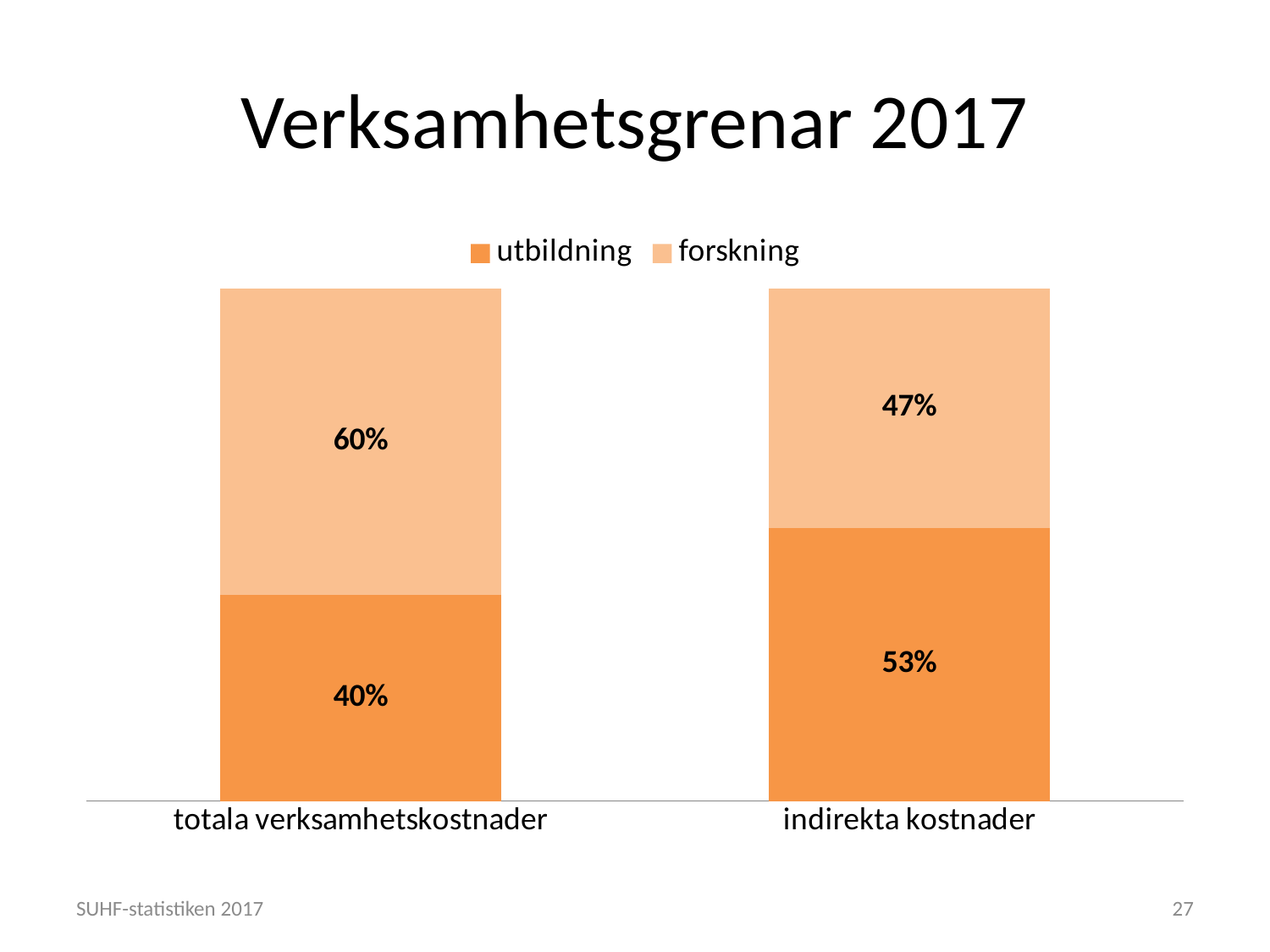
How many series does the legend list? 2 What is the value for forskning in the totala verksamhetskostnader bar? 60% What is the difference between the forskning and utbildning values for totala verksamhetskostnader? 20% Which category has the higher value for forskning? totala verksamhetskostnader What is the value for utbildning in the totala verksamhetskostnader bar? 40% What is the difference between the utbildning values for indirekta kostnader and totala verksamhetskostnader? 13% What kind of chart is shown on the slide? stacked bar chart What is the total of the stacked bar for indirekta kostnader? 100% What is the value for utbildning in the indirekta kostnader bar? 53% Which category has the higher value for utbildning? indirekta kostnader How many categories are shown on the x axis? 2 What is the value for forskning in the indirekta kostnader bar? 47%